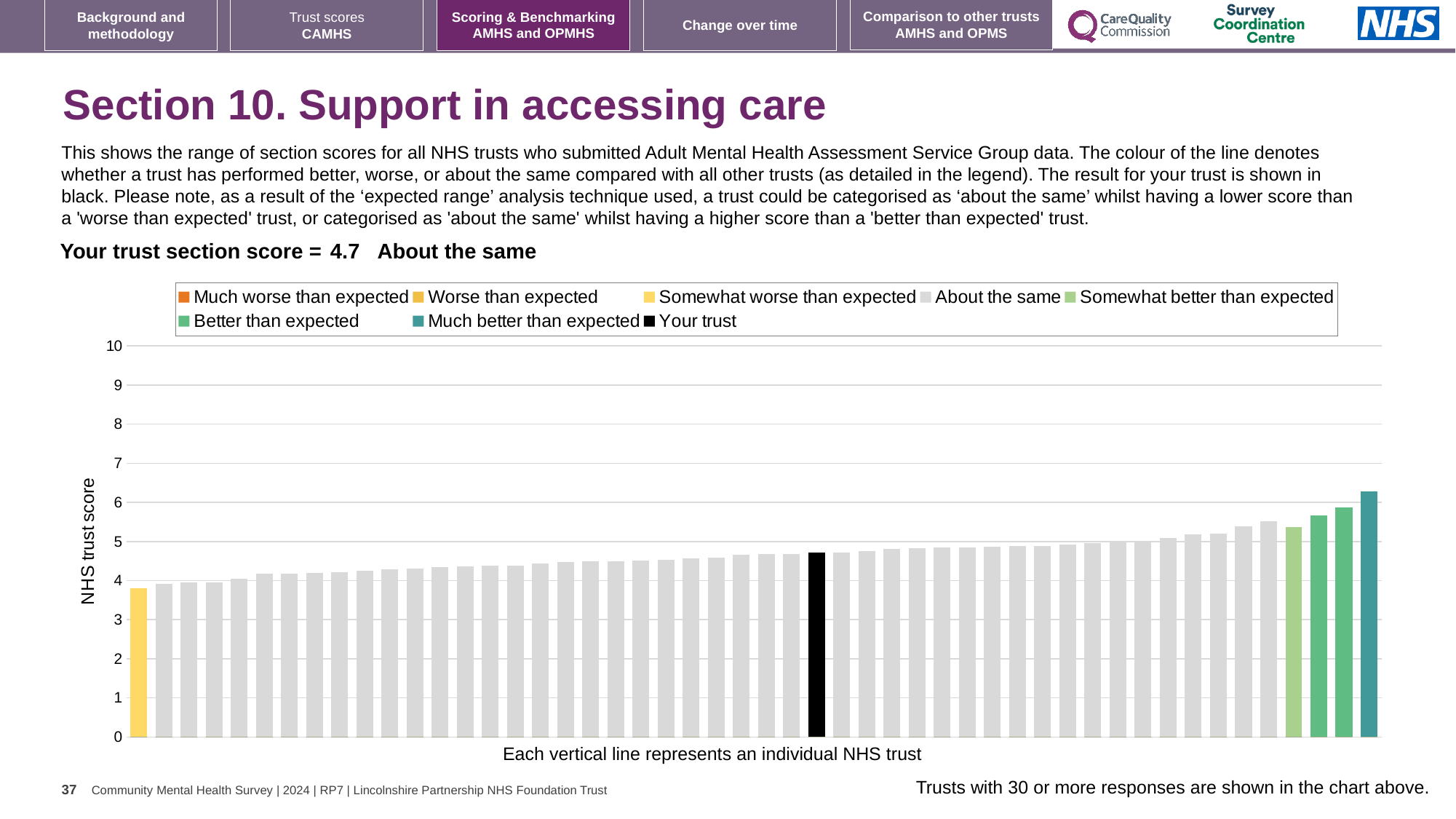
Is the value of the shortest bar in the chart greater or less than 5? less What is the section score for your trust shown on the slide? 4.7 How is your trust's section score categorised compared with other trusts? About the same Which legend category does the tallest bar in the chart belong to? Much better than expected Do the bar values rise or fall from left to right along the x axis? rise What kind of chart is shown on the slide? bar chart Is the value of the tallest bar in the chart greater or less than 6? greater Is the value of the tallest bar in the chart greater or less than 7? less How many bars are coloured as 'Much better than expected'? 1 What is the label on the vertical axis of the chart? NHS trust score How many entries does the chart legend list? 8